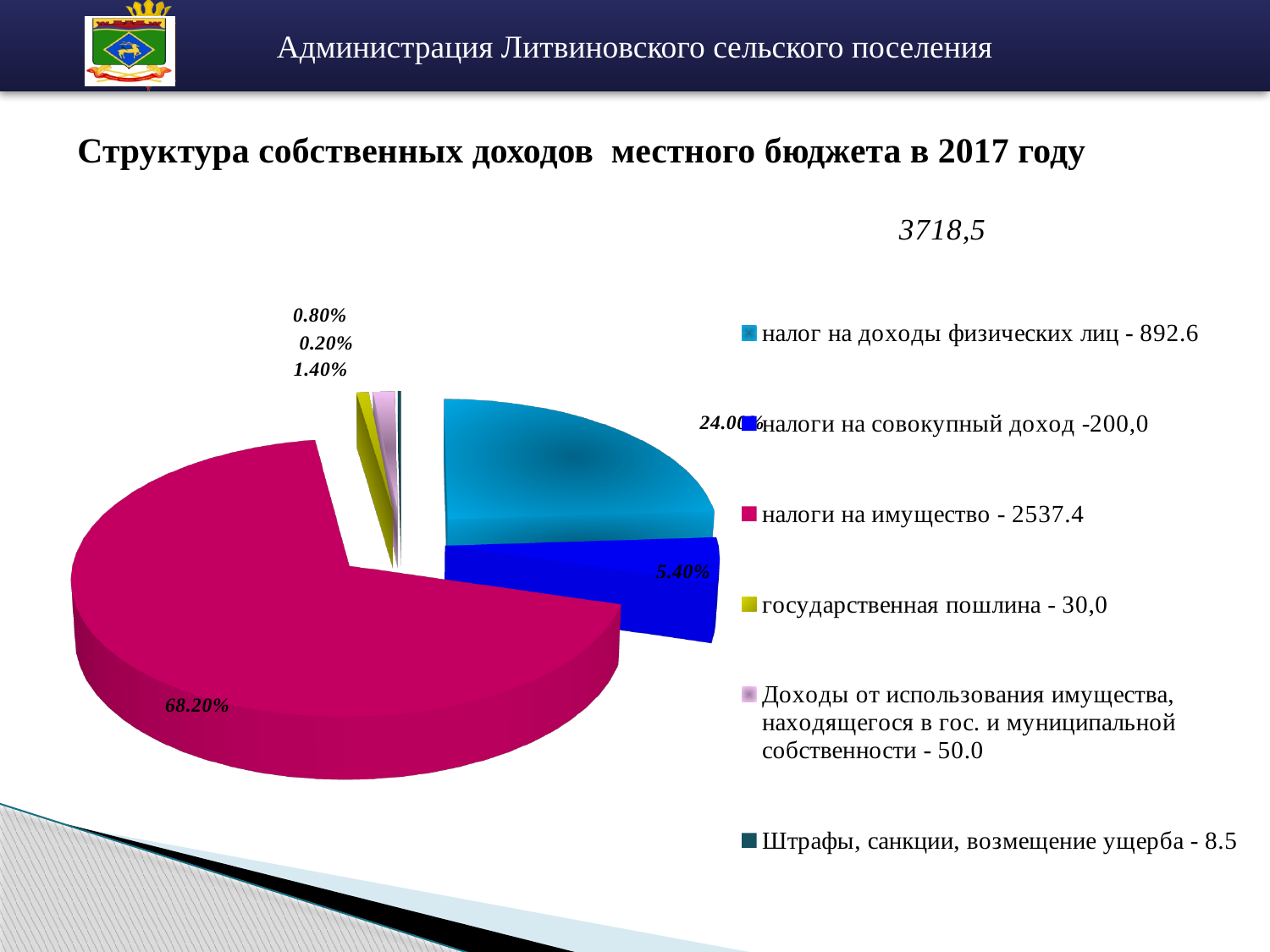
What value is given in the legend for 'налоги на имущество'? 2537.4 Which category has the largest slice of the pie? налоги на имущество What share of the pie does 'налог на доходы физических лиц' take? 24.00% What kind of chart is shown on the slide? pie chart What is the difference in percentage points between the 'налоги на имущество' slice (68.20%) and the 'налог на доходы физических лиц' slice (24.00%)? 44.20% How many entries does the legend list? 6 What share of the pie does 'налоги на имущество' take? 68.20% What value is given in the legend for 'государственная пошлина'? 30,0 Which is larger: 'налог на доходы физических лиц' or 'налоги на совокупный доход'? налог на доходы физических лиц What share of the pie does 'налоги на совокупный доход' take? 5.40% How many slices does the pie chart have? 6 Which category has the smallest value in the legend? Штрафы, санкции, возмещение ущерба